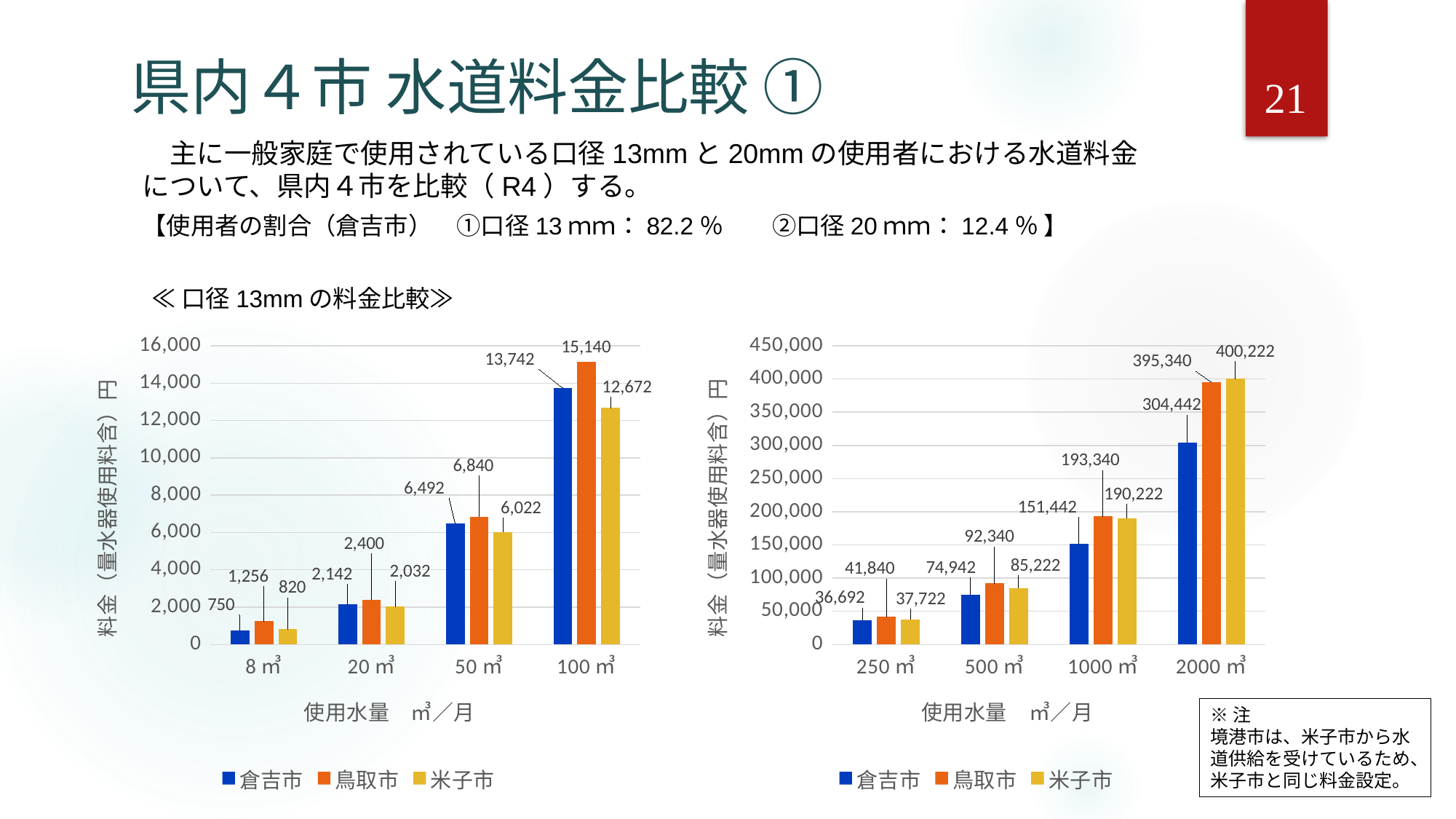
In the left chart (8–100 ㎥), which city has the highest value at 50 ㎥? 鳥取市 In the right chart (250–2000 ㎥), what is the value for 倉吉市 at 1000 ㎥? 151,442 In the left chart (8–100 ㎥), what is the value for 倉吉市 at 8 ㎥? 750 In the left chart (8–100 ㎥), what is the value for 鳥取市 at 100 ㎥? 15,140 In the right chart (250–2000 ㎥), is the value for 倉吉市 at 2000 ㎥ greater or less than 350,000? less In the left chart (8–100 ㎥), which is larger at 20 ㎥: 倉吉市 or 米子市? 倉吉市 In the left chart (8–100 ㎥), what is the difference between 鳥取市 and 米子市 at 100 ㎥? 2,468 How many series does the legend of the left chart list? 3 In the right chart (250–2000 ㎥), what is the difference between 鳥取市 and 倉吉市 at 2000 ㎥? 90,898 What kind of chart is the right chart (250–2000 ㎥)? bar chart In the right chart (250–2000 ㎥), what is the value for 米子市 at 2000 ㎥? 400,222 In the right chart (250–2000 ㎥), which city has the lowest value at 500 ㎥? 倉吉市